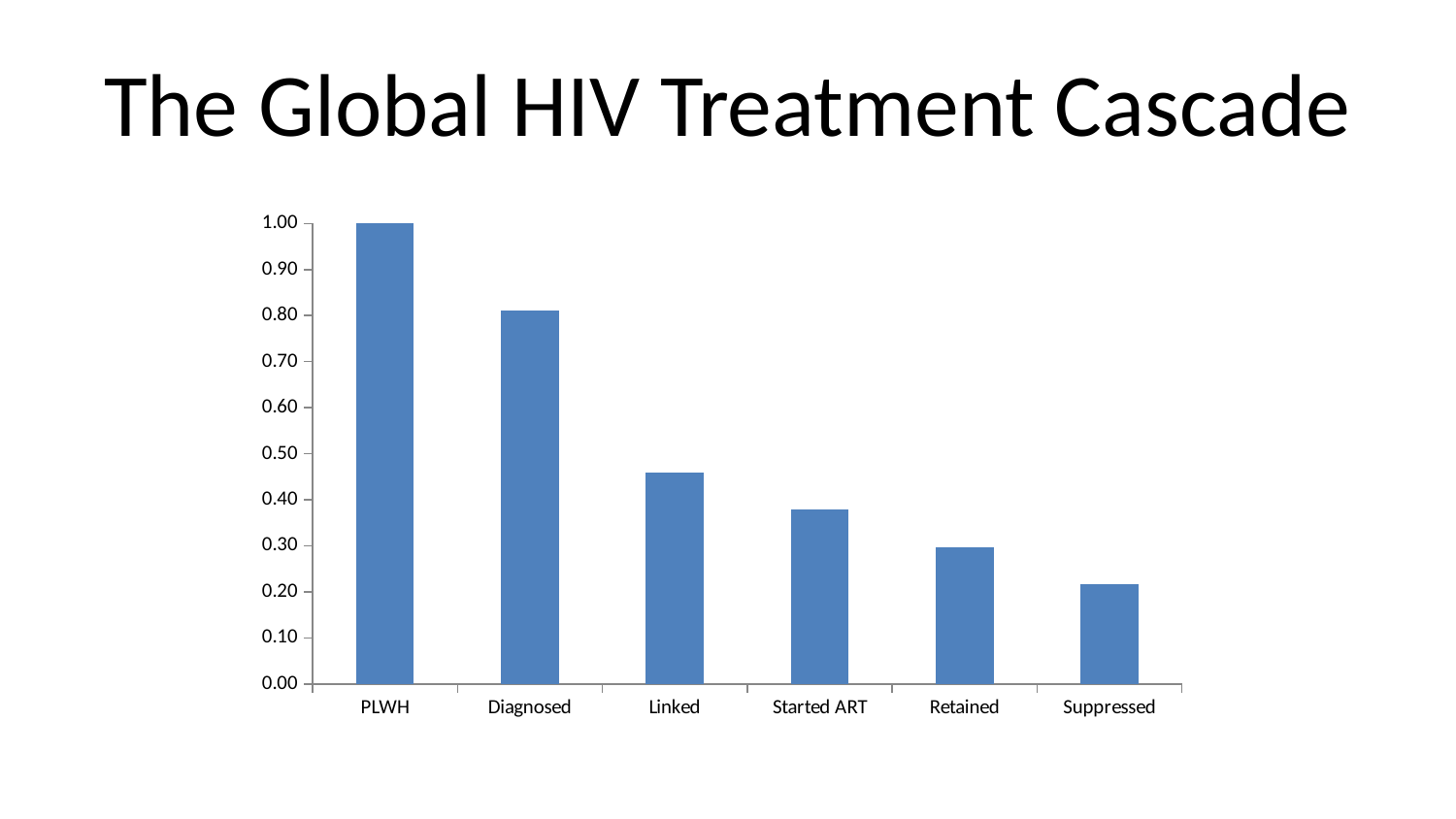
What is the title of the slide? The Global HIV Treatment Cascade Is the value for Diagnosed greater or less than 0.90? less Is the value for Started ART greater or less than 0.30? greater What kind of chart is shown on the slide? bar chart What is the value for PLWH? 1.00 Which category has the highest value? PLWH Is the value for Suppressed greater or less than 0.30? less Do the values rise or fall from PLWH to Suppressed along the x axis? fall Which is larger, the value for Diagnosed or the value for Linked? Diagnosed How many categories are shown on the x axis? 6 Which category has the lowest value? Suppressed